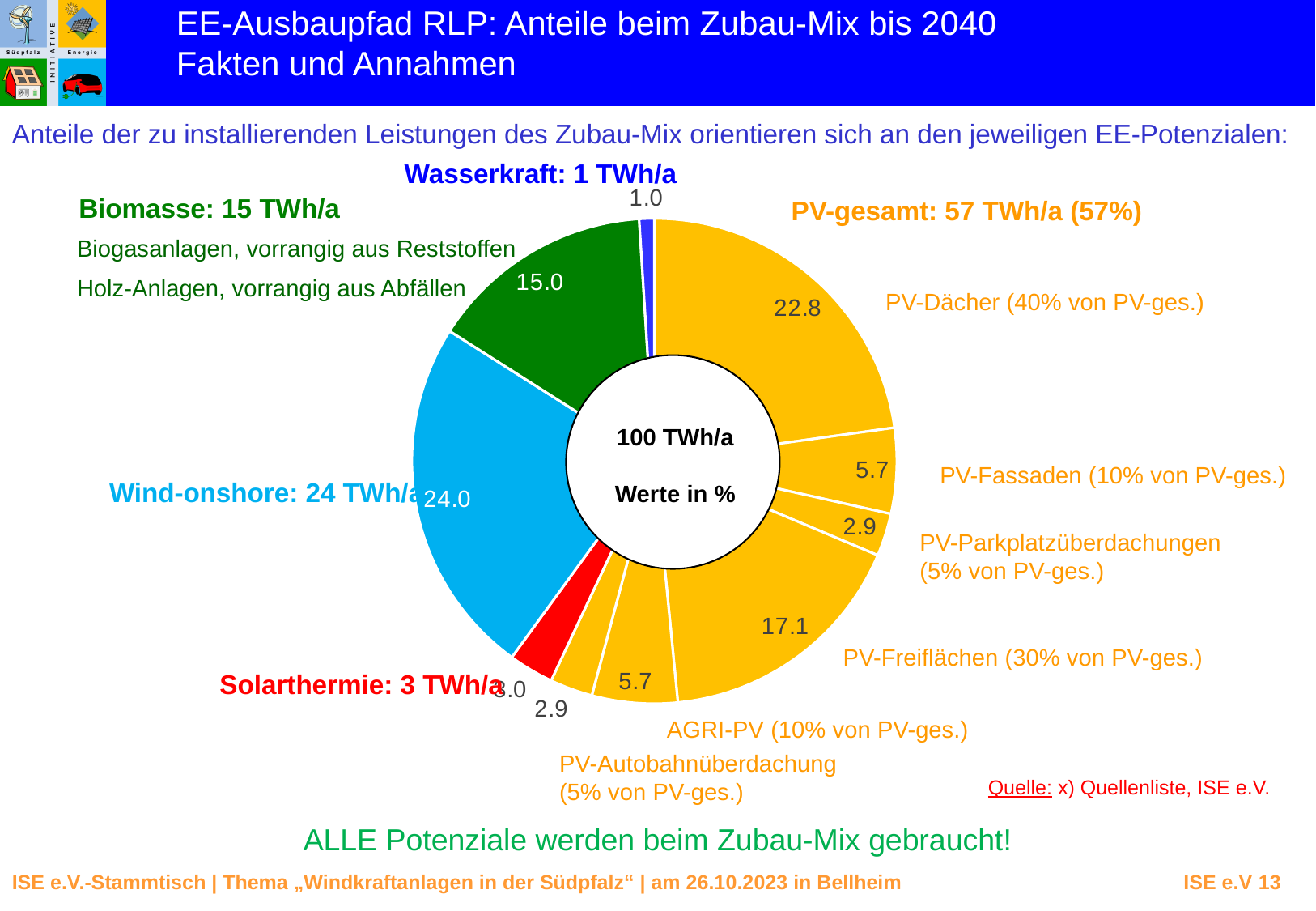
Which is larger, the PV-Dächer slice or the PV-Freiflächen slice? PV-Dächer What value is shown for the PV-Freiflächen slice? 17.1 What text is shown in the centre of the doughnut chart? 100 TWh/a, Werte in % What value is shown for the Wasserkraft slice? 1.0 What value is shown for the Biomasse slice? 15.0 What value is shown for the Wind-onshore slice? 24.0 What is the difference between the Wind-onshore value and the Biomasse value? 9.0 What value is shown for the PV-Dächer slice? 22.8 Which slice has the smallest value? Wasserkraft What kind of chart is shown on the slide? Doughnut (pie) chart How many slices does the chart have? 10 Which slice has the largest value? Wind-onshore